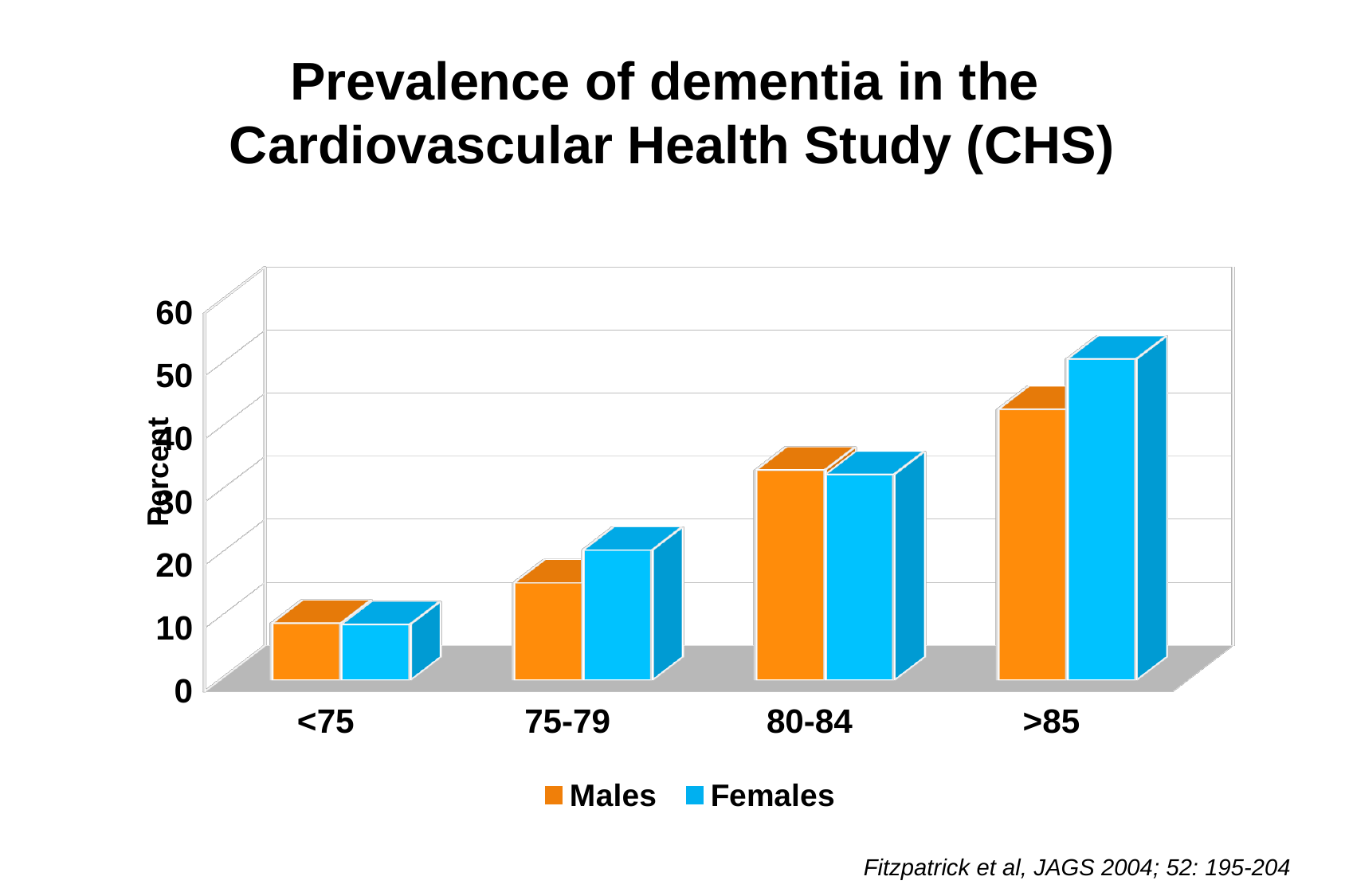
Do the values for Males rise or fall as age group increases along the x axis? rise Is the value for Females in the 80-84 age group greater or less than 30? greater Which series and age group has the highest bar in the chart? Females, >85 For the Females series, which age group has the lowest value? <75 How many age groups are shown on the x axis? 4 What kind of chart is shown on the slide? bar chart In the 75-79 age group, which is larger, the value for Males or for Females? Females Is the value for Males in the >85 age group greater or less than 40? greater How many series does the legend list? 2 Is the value for Males in the 75-79 age group greater or less than 20? less What is the label on the vertical axis? Percent In the >85 age group, which is larger, the value for Males or for Females? Females